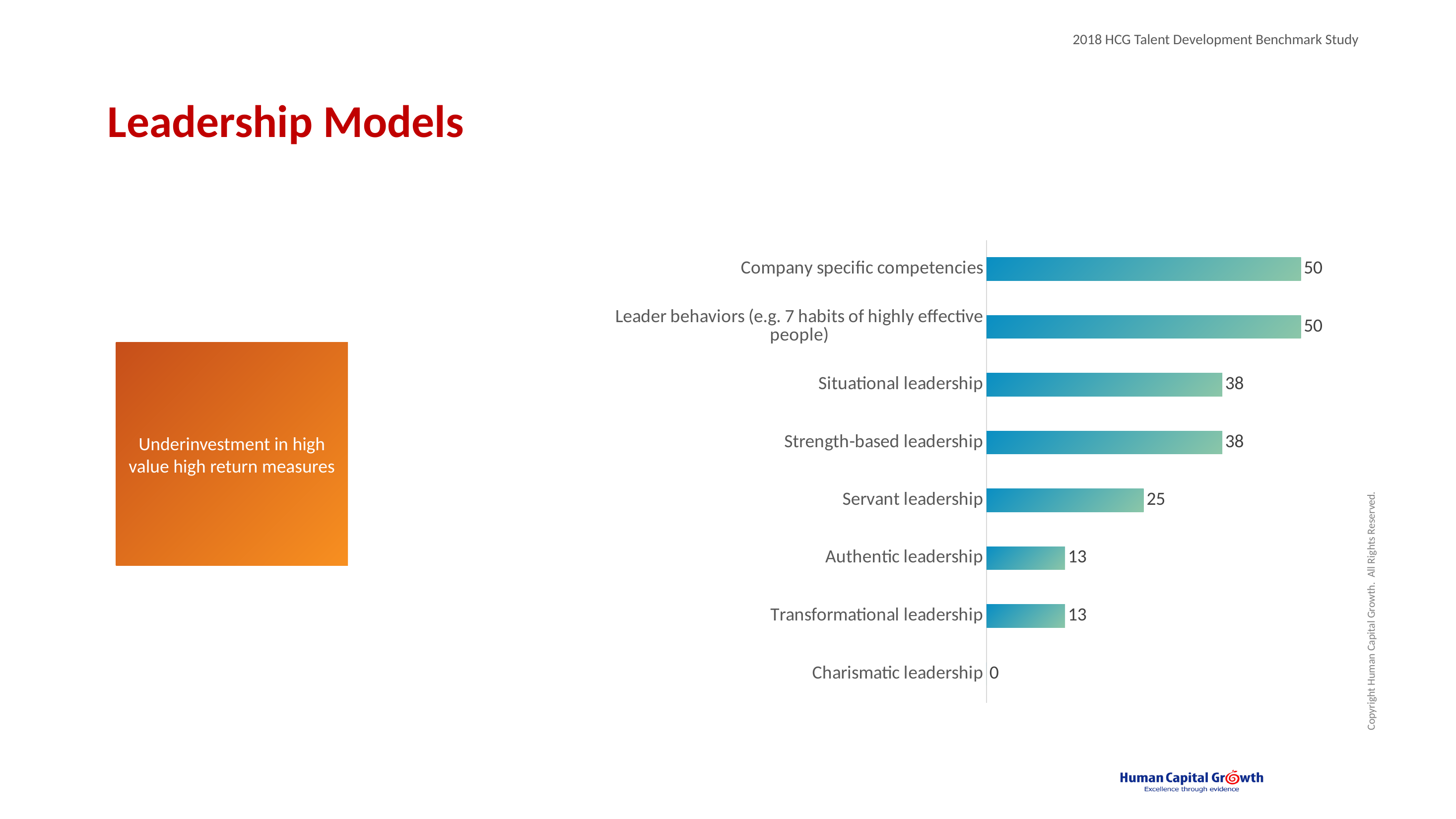
What is the value for Servant leadership? 25 Which category has the lowest value? Charismatic leadership What is the difference between the values for Strength-based leadership and Transformational leadership? 25 How many categories are shown in the chart? 8 Which is larger, the value for Authentic leadership or the value for Strength-based leadership? Strength-based leadership What is the difference between the values for Company specific competencies and Servant leadership? 25 What is the value for Charismatic leadership? 0 What kind of chart is shown on the slide? Bar chart What is the value for Situational leadership? 38 What is the title of the slide containing the chart? Leadership Models Which is larger, the value for Situational leadership or the value for Servant leadership? Situational leadership What is the value for Authentic leadership? 13